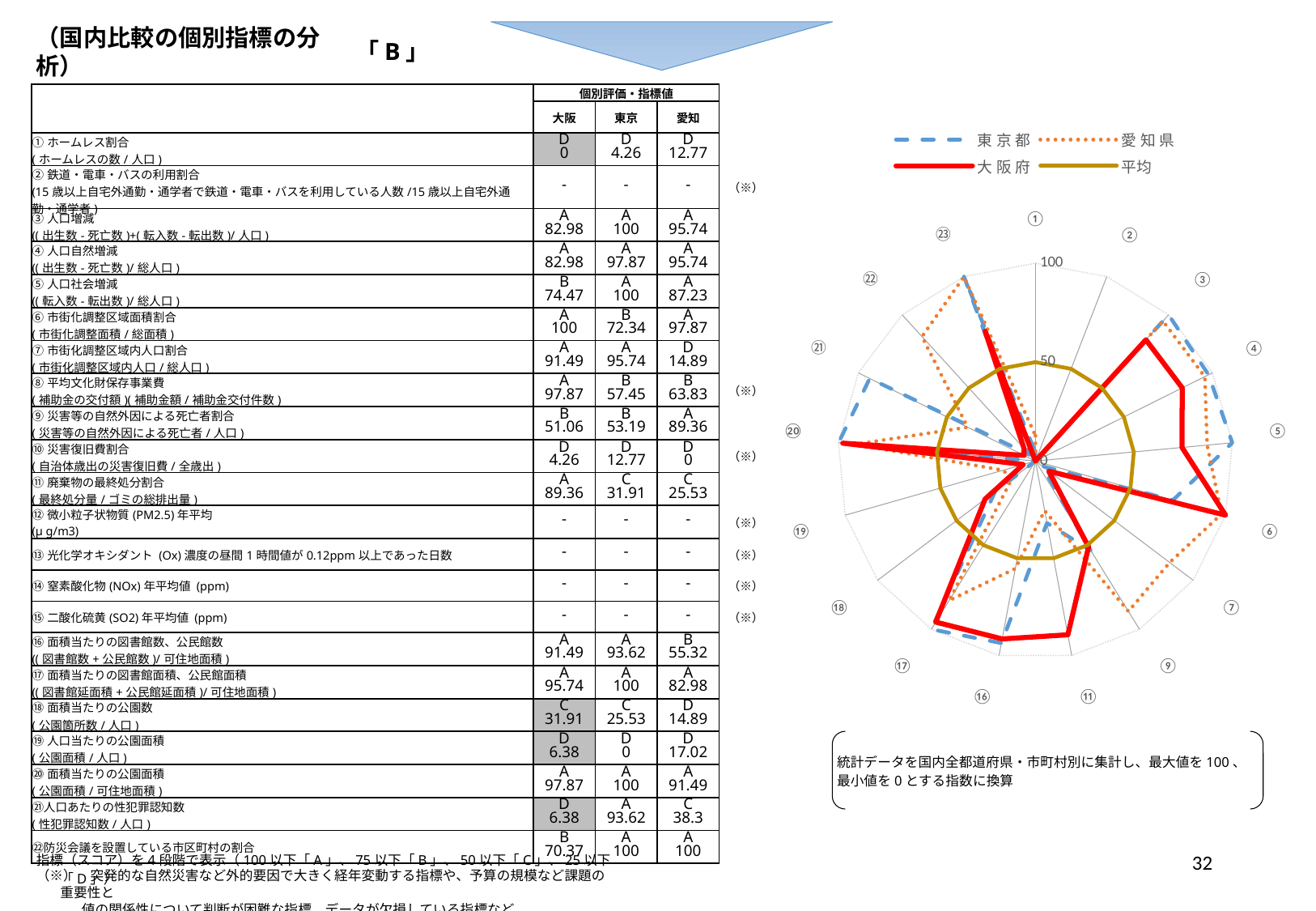
In the radar chart, is the value for 東京都 at ⑤ greater or less than 50? greater Which series are listed in the legend of the radar chart? 東京都, 愛知県, 大阪府, 平均 What kind of chart is shown on the right side of the slide? Radar chart In the radar chart, is the value for 大阪府 at ⑳ greater or less than 50? greater In the radar chart, is the value for 大阪府 at ① greater or less than 50? less What is the maximum value shown on the radial axis of the radar chart? 100 How many series does the legend of the radar chart list? 4